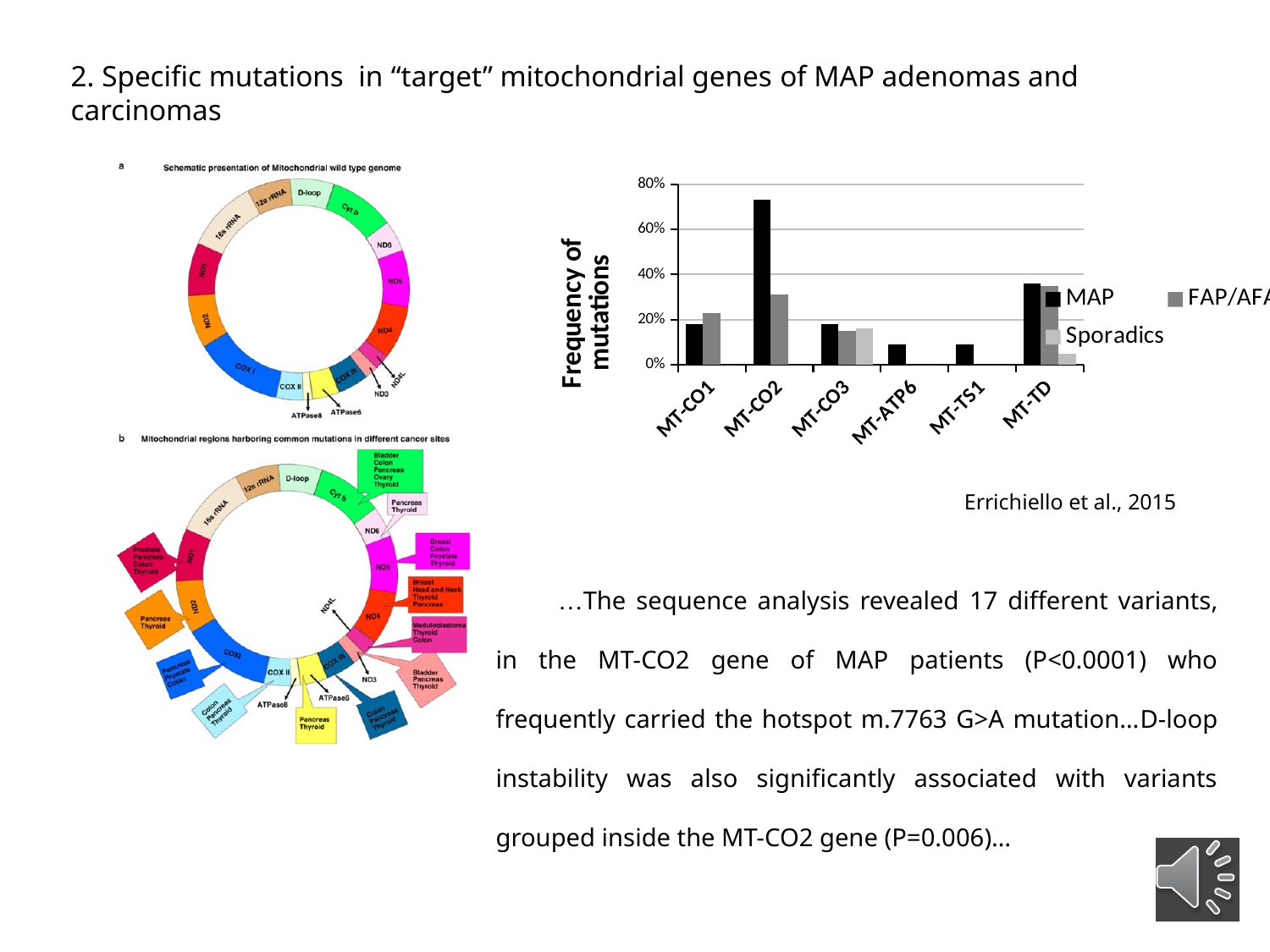
Is the MAP value for MT-ATP6 greater or less than 20%? less What kind of chart is shown on the right of the slide? bar chart How many gene categories are shown on the x axis of the bar chart? 6 Is the FAP/AFAP value for MT-CO2 greater or less than 40%? less Which gene has the highest frequency of mutations for the MAP series? MT-CO2 Is the MAP value for MT-CO2 greater or less than 60%? greater For MT-CO2, which series has the larger value, MAP or FAP/AFAP? MAP How many series does the legend of the bar chart list? 3 What is the label on the y axis of the bar chart? Frequency of mutations Which series has the larger value for MT-TD, MAP or Sporadics? MAP Which series is drawn in black in the bar chart? MAP